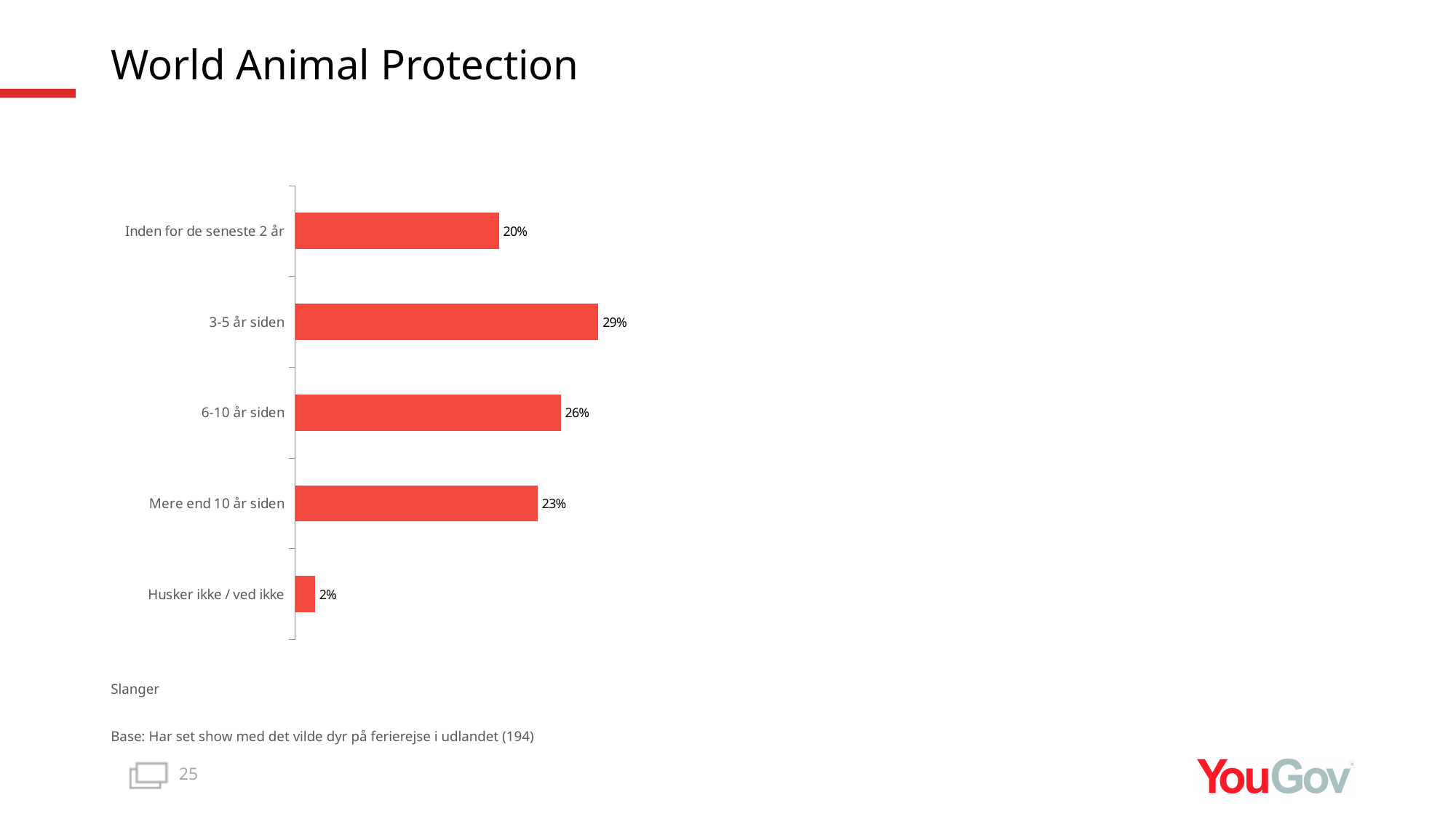
Which category has the highest value? 3-5 år siden What is the value for "3-5 år siden"? 29% Which category has the lowest value? Husker ikke / ved ikke What is the value for "Mere end 10 år siden"? 23% What is the base described below the chart? Har set show med det vilde dyr på ferierejse i udlandet (194) What is the value for "Inden for de seneste 2 år"? 20% Which is larger: the value for "6-10 år siden" or the value for "Mere end 10 år siden"? 6-10 år siden What is the value for "6-10 år siden"? 26% How many categories are shown in the chart? 5 What is the value for "Husker ikke / ved ikke"? 2% What kind of chart is shown on the slide? Bar chart What is the difference between the values for "3-5 år siden" and "Inden for de seneste 2 år"? 9%